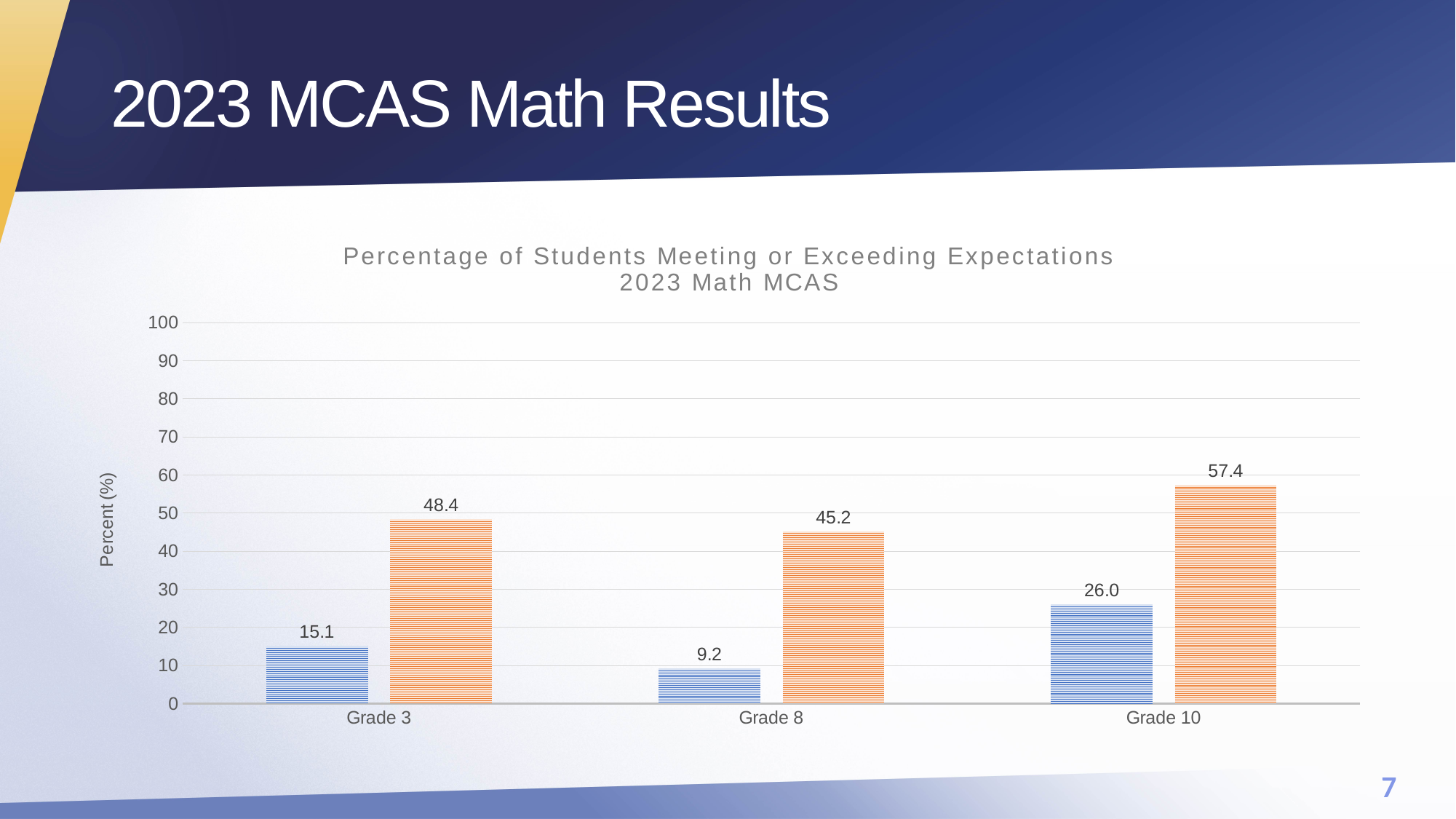
What is the value of the orange bar for Grade 10? 57.4 What is the value of the orange bar for Grade 8? 45.2 What is the value of the blue bar for Grade 8? 9.2 Which grade has the lowest blue bar? Grade 8 How many grade categories are shown on the x axis? 3 What is the difference between the blue bar values for Grade 10 and Grade 8? 16.8 What is the difference between the orange bar and the blue bar for Grade 3? 33.3 What type of chart is shown on the slide? Bar chart Which grade has the highest orange bar? Grade 10 Which is larger, the orange bar for Grade 3 or the orange bar for Grade 8? Grade 3 What is the value of the blue bar for Grade 3? 15.1 What is the label on the vertical axis of the chart? Percent (%)